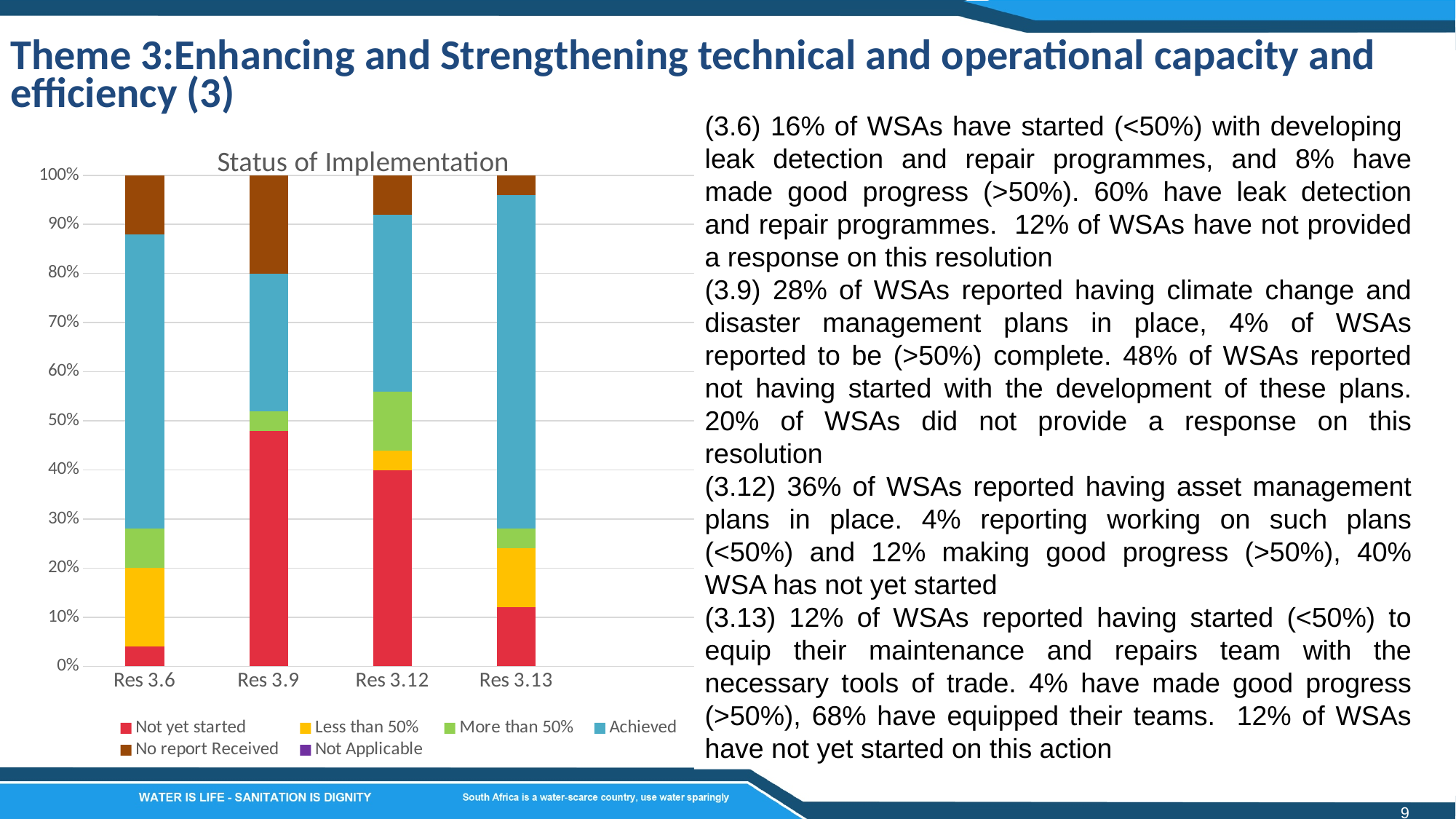
What colour represents the 'Achieved' series in the chart? Blue What is the total height of each stacked bar in the chart? 100% How many resolutions (categories) are shown on the x axis of the chart? 4 Which is larger: the 'Not yet started' segment for Res 3.9 or for Res 3.6? Res 3.9 Is the 'Not yet started' segment for Res 3.13 greater or less than 20%? less Which resolution has the largest 'Not yet started' segment? Res 3.9 Is the 'Not yet started' segment for Res 3.9 greater or less than 40%? greater What is the title of the chart? Status of Implementation Which resolution has the largest 'Achieved' segment? Res 3.13 Which resolution has the smallest 'No report Received' segment? Res 3.13 How many series does the chart legend list? 6 What type of chart is shown on the slide? Stacked bar chart